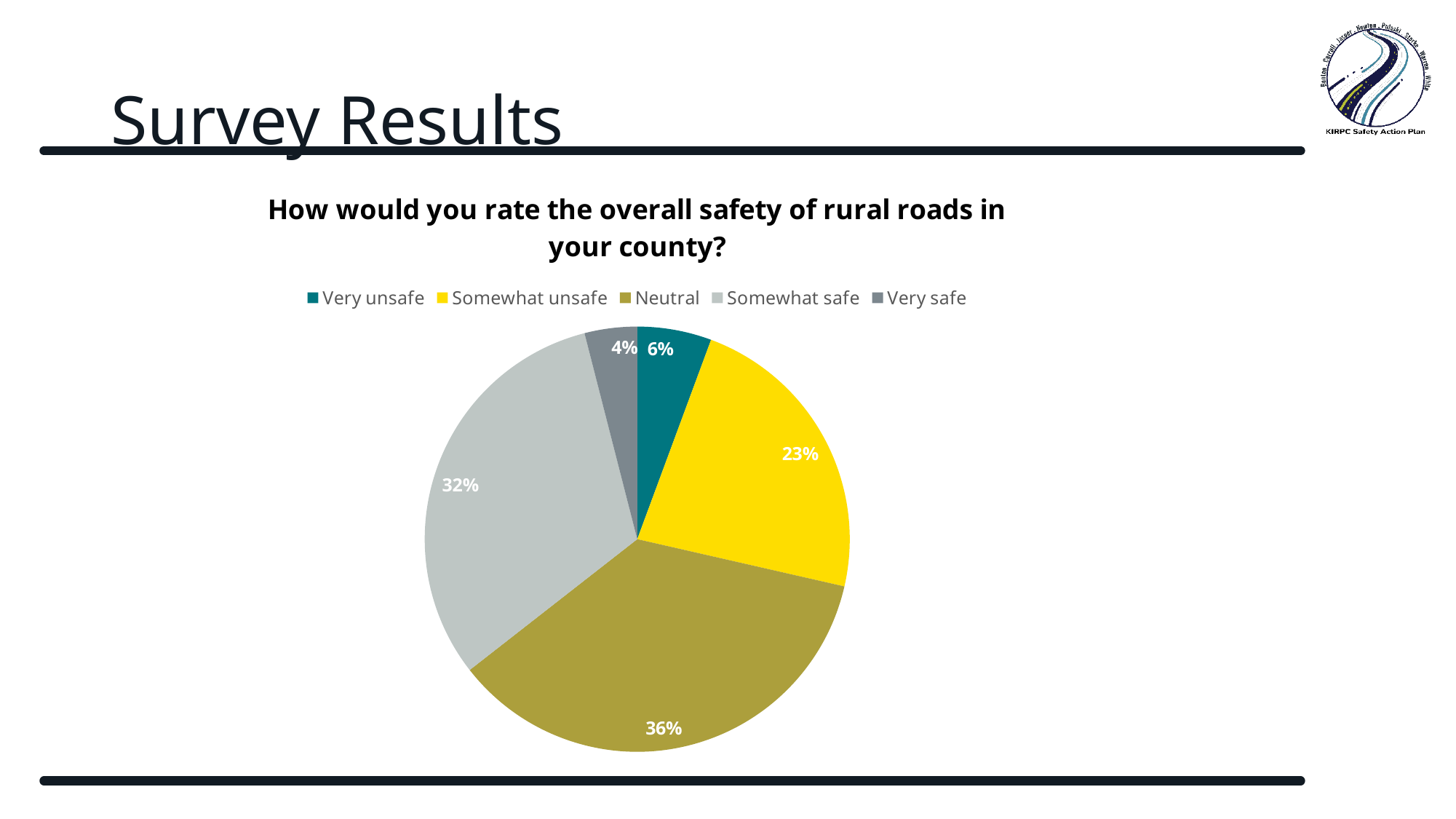
What is the title of the chart? How would you rate the overall safety of rural roads in your county? Which response category has the largest share of the pie? Neutral Which is larger, the share for Very unsafe or the share for Very safe? Very unsafe What percentage of respondents rated rural road safety as Very safe? 4% What percentage of respondents rated rural road safety as Neutral? 36% What type of chart is shown on the slide? Pie chart What percentage of respondents rated rural road safety as Very unsafe? 6% What is the combined percentage for Somewhat safe and Very safe? 36% What is the difference in percentage points between Somewhat safe and Somewhat unsafe? 9 Which response category has the smallest share of the pie? Very safe How many response categories are shown in the pie chart? 5 What percentage of respondents rated rural road safety as Somewhat unsafe? 23%